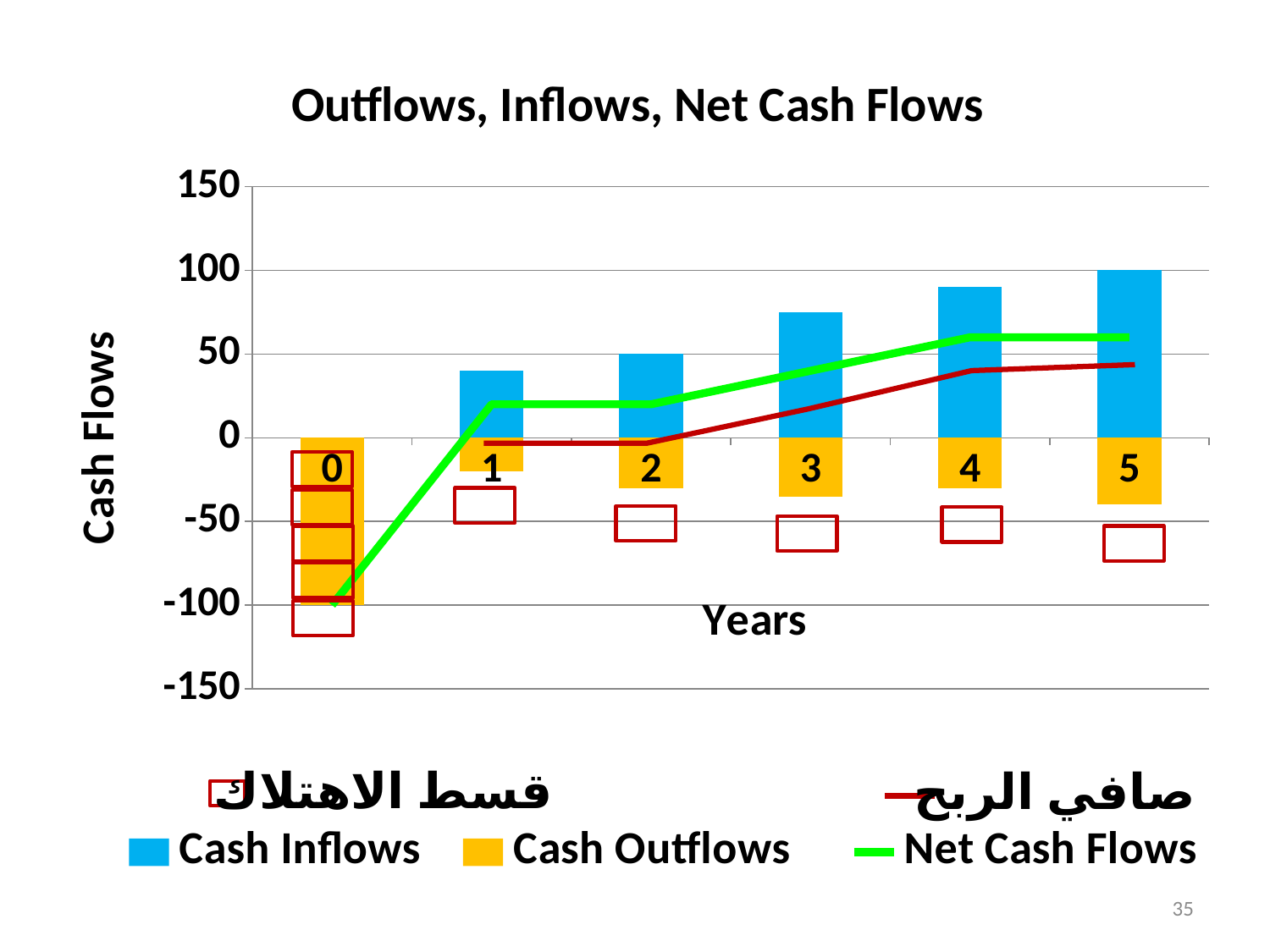
What kind of chart is shown on the slide? Combined bar and line chart How many series does the legend list? 3 Do the Cash Inflows bars rise or fall from year 1 to year 5? Rise What is the label of the x axis? Years In which year is the Cash Inflows bar the highest? 5 Which is larger, the Cash Inflows value in year 5 or in year 1? Year 5 Is the Cash Inflows value in year 4 greater or less than 50? greater What is the title of the chart? Outflows, Inflows, Net Cash Flows What is the Cash Outflows value in year 0? -100 What is the Cash Inflows value in year 5? 100 Is the Net Cash Flows value in year 1 greater or less than 50? less How many years (categories) are plotted on the x axis? 6